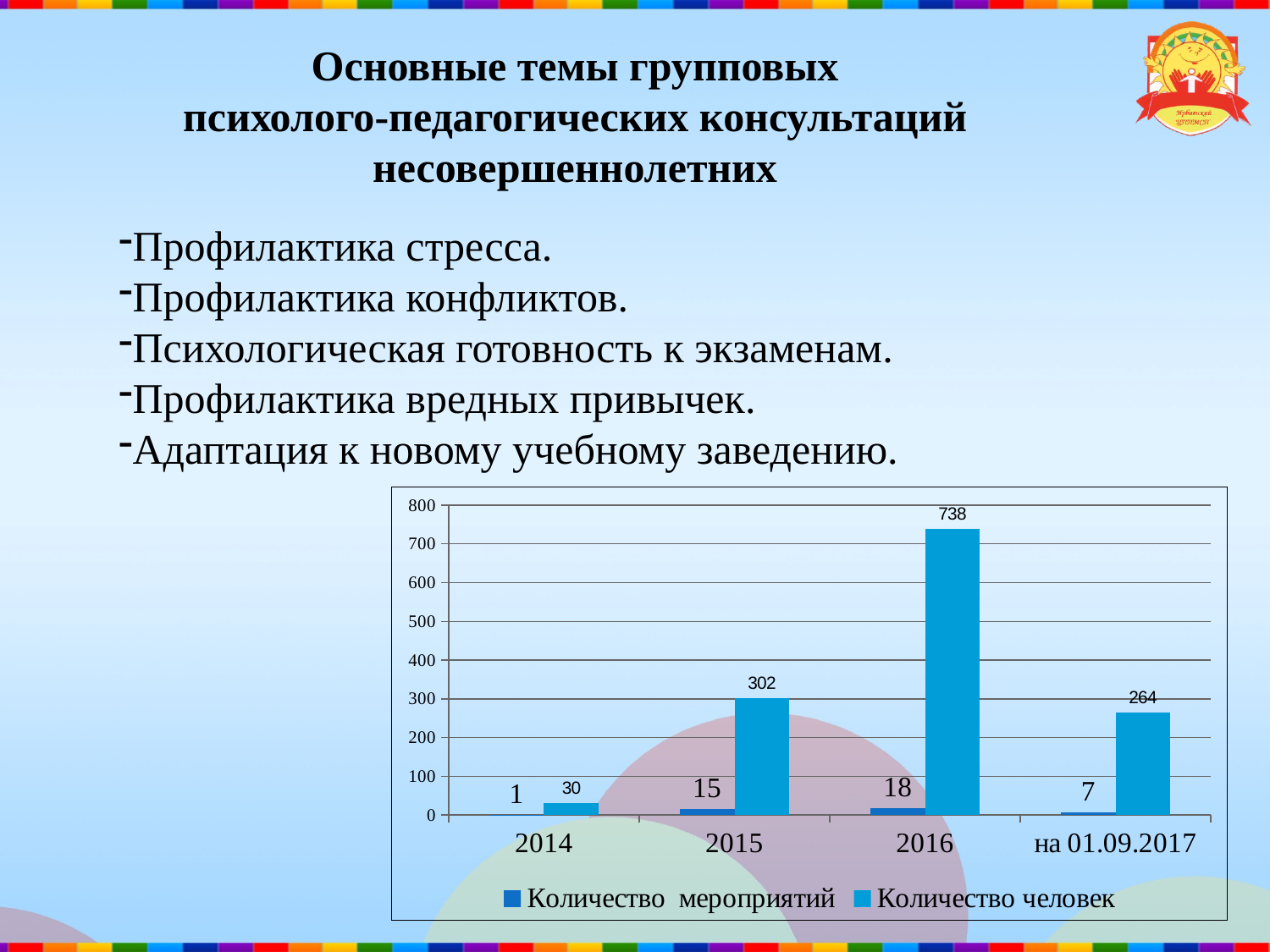
What is the value of Количество человек for на 01.09.2017? 264 How many series does the chart legend list? 2 What is the value of Количество человек for 2016? 738 Does Количество человек rise or fall from 2014 to 2016? rise Which category has the lowest value for Количество мероприятий? 2014 Which is larger: Количество человек in 2015 or in на 01.09.2017? 2015 What is the name of the second series in the chart legend? Количество человек What kind of chart is shown on the slide? bar chart What is the value of Количество мероприятий for 2015? 15 What is the difference between Количество человек in 2016 and in 2015? 436 Which category has the highest value for Количество человек? 2016 How many categories are shown on the x axis of the chart? 4